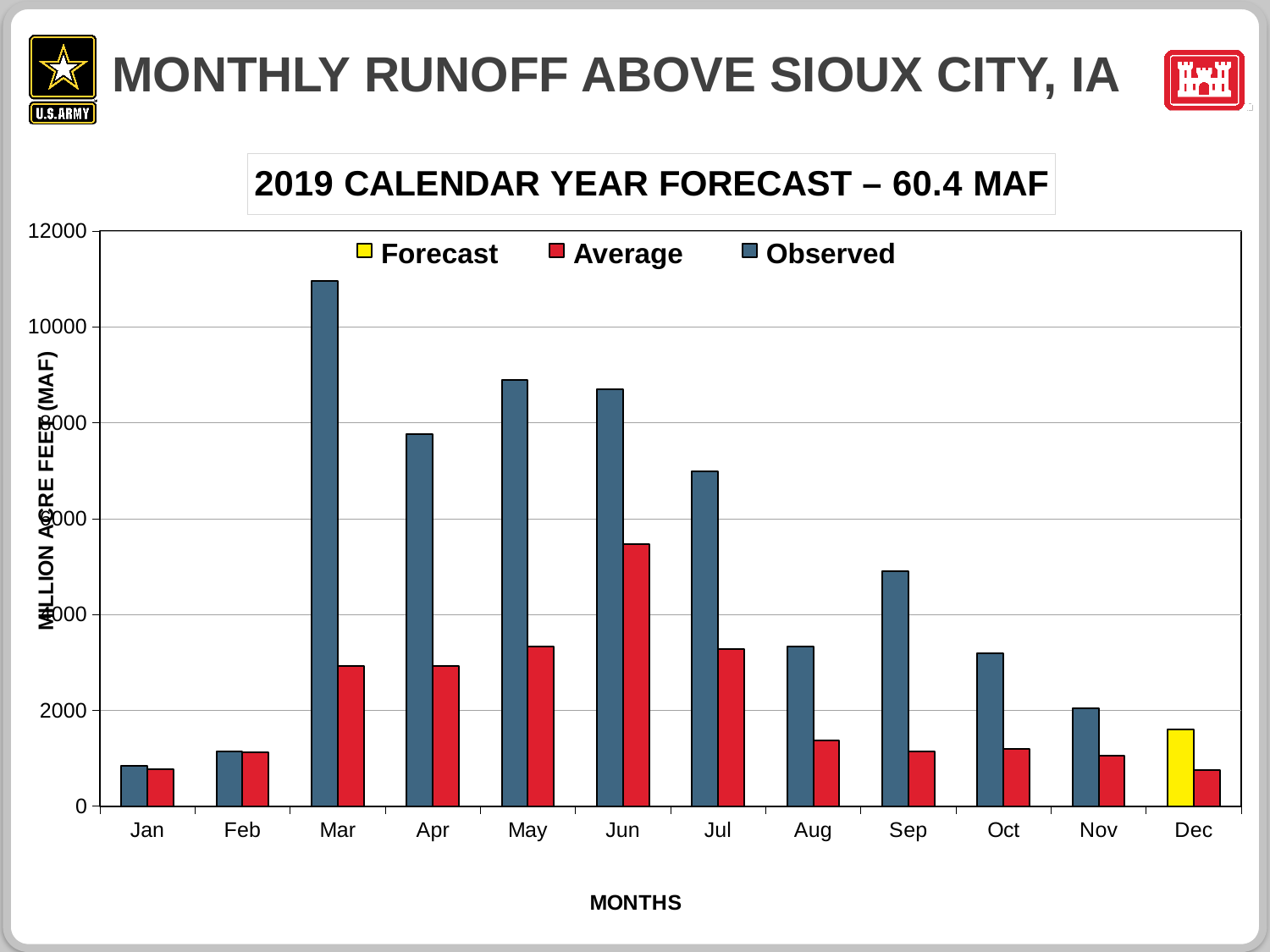
Which month has the highest Average runoff? Jun Is the Average value for Jun greater or less than 4000? greater Is the Observed value for Jul greater or less than 6000? greater What kind of chart is shown on the slide? bar chart In Sep, which is larger, the Observed value or the Average value? Observed Is the Observed value for Mar greater or less than 10000? greater Which month has the lowest Observed runoff? Jan How many series does the legend list? 3 Do the Observed values rise or fall from Sep to Nov? fall Which month has a Forecast bar instead of an Observed bar? Dec How many months are shown along the x axis? 12 Which month has the highest Observed runoff? Mar